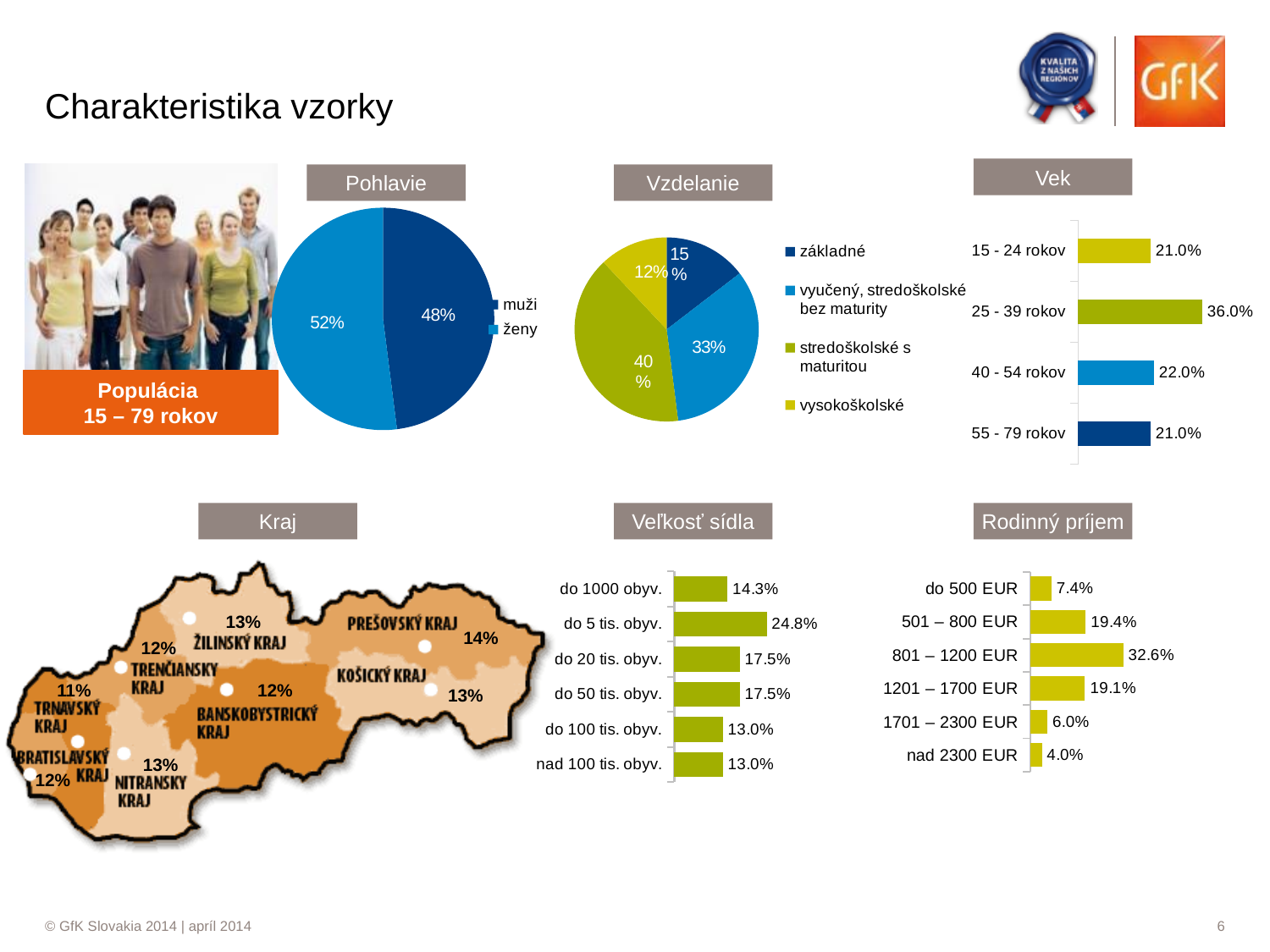
In the 'Pohlavie' pie chart, which of the two categories has the larger share, 'muži' or 'ženy'? ženy In the 'Pohlavie' pie chart, what share is labelled for 'ženy'? 52% In the 'Vzdelanie' pie chart, what share is shown for 'stredoškolské s maturitou'? 40% In the 'Vzdelanie' pie chart, which category has the smallest share? vysokoškolské What kind of chart is the 'Vek' chart? bar chart In the 'Vek' chart, what is the value for '25 - 39 rokov'? 36.0% How many categories are shown in the 'Veľkosť sídla' chart? 6 In the 'Rodinný príjem' chart, which category has the lowest value? nad 2300 EUR In the 'Rodinný príjem' chart, what is the value for '801 – 1200 EUR'? 32.6% How many categories does the legend of the 'Vzdelanie' pie chart list? 4 In the 'Vek' chart, what is the difference between the values for '25 - 39 rokov' and '40 - 54 rokov'? 14.0% In the 'Veľkosť sídla' chart, which category has the highest value? do 5 tis. obyv.